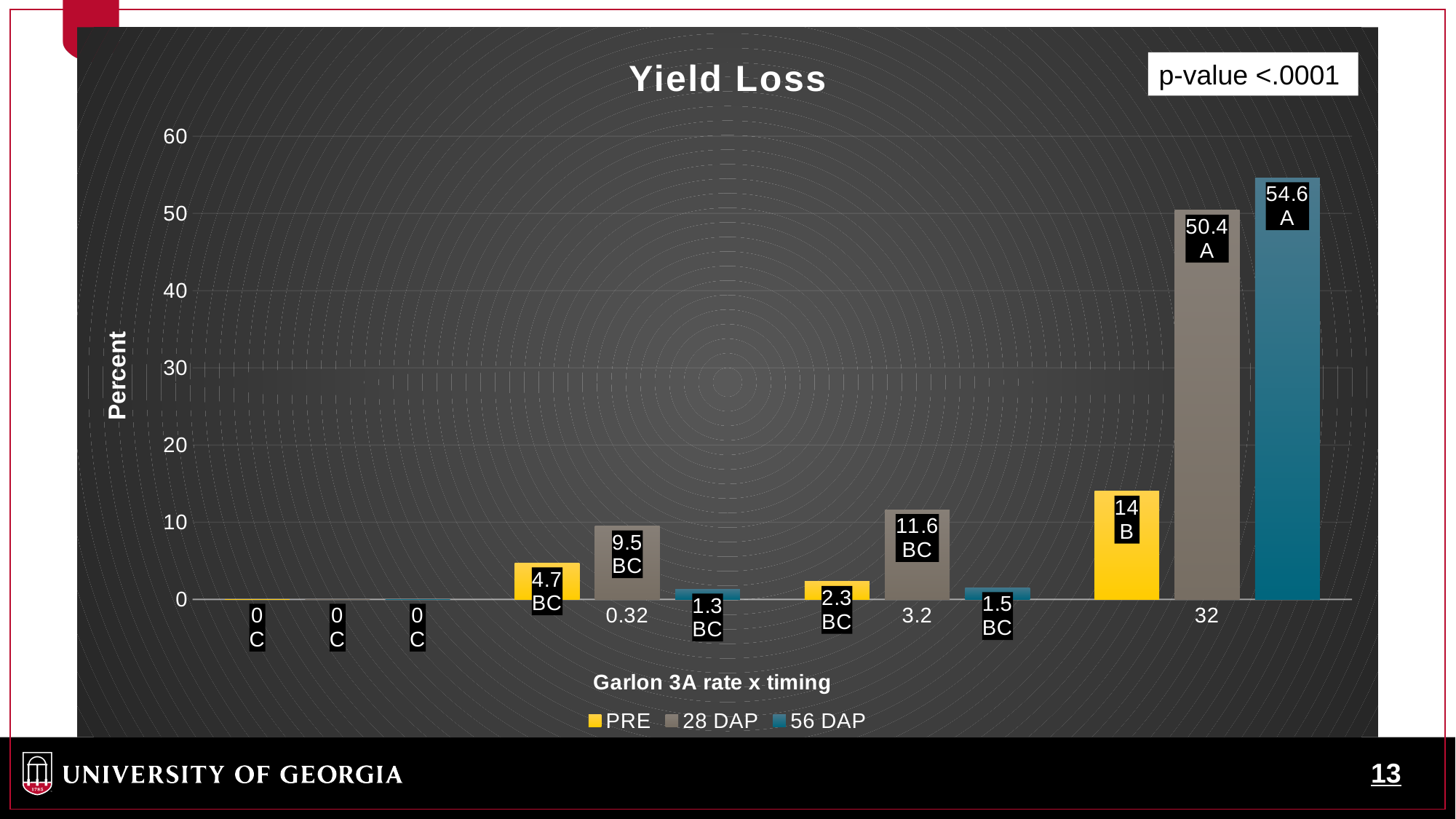
Is the PRE value at the 32 rate greater or less than 10? greater What is the yield loss percent for PRE at the 3.2 rate? 2.3 What is the title of the chart? Yield Loss What type of chart is shown on the slide? bar chart Which is larger, the 28 DAP value at the 3.2 rate or the 28 DAP value at the 0.32 rate? 28 DAP at 3.2 Which series has the lowest yield loss at the 0.32 rate? 56 DAP How many series does the legend list? 3 Which series has the highest yield loss at the 32 rate? 56 DAP What is the yield loss percent for 56 DAP at the 32 rate? 54.6 What is the yield loss percent for 56 DAP at the 3.2 rate? 1.5 What is the difference between the 28 DAP and PRE yield loss values at the 32 rate? 36.4 What is the yield loss percent for 28 DAP at the 0.32 rate? 9.5